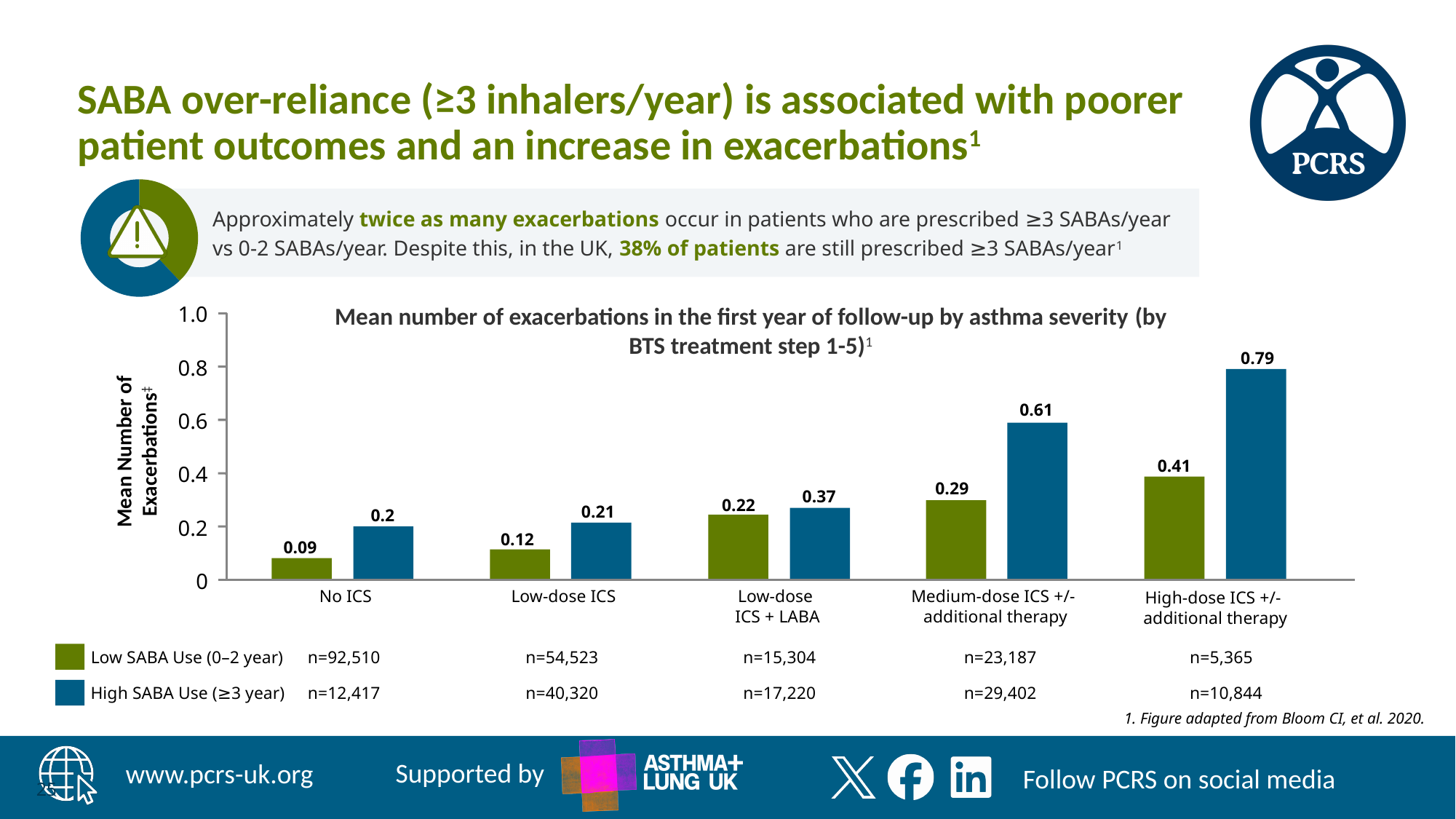
Which treatment group has the highest mean number of exacerbations for High SABA Use? High-dose ICS +/- additional therapy In the Low-dose ICS group, which is larger: the Low SABA Use value or the High SABA Use value? High SABA Use How many series does the legend list? 2 What is the difference between the High SABA Use and Low SABA Use values in the Medium-dose ICS +/- additional therapy group? 0.32 Which treatment group has the lowest mean number of exacerbations for Low SABA Use? No ICS What kind of chart is shown on the slide? Bar chart What is the mean number of exacerbations for High SABA Use in the Low-dose ICS + LABA group? 0.37 How many treatment groups are shown on the x axis? 5 What is the mean number of exacerbations for Low SABA Use in the No ICS group? 0.09 Is the High SABA Use value for the Medium-dose ICS +/- additional therapy group greater or less than 0.4? greater What is the mean number of exacerbations for High SABA Use in the High-dose ICS +/- additional therapy group? 0.79 Do the High SABA Use values rise or fall from No ICS to High-dose ICS +/- additional therapy? Rise